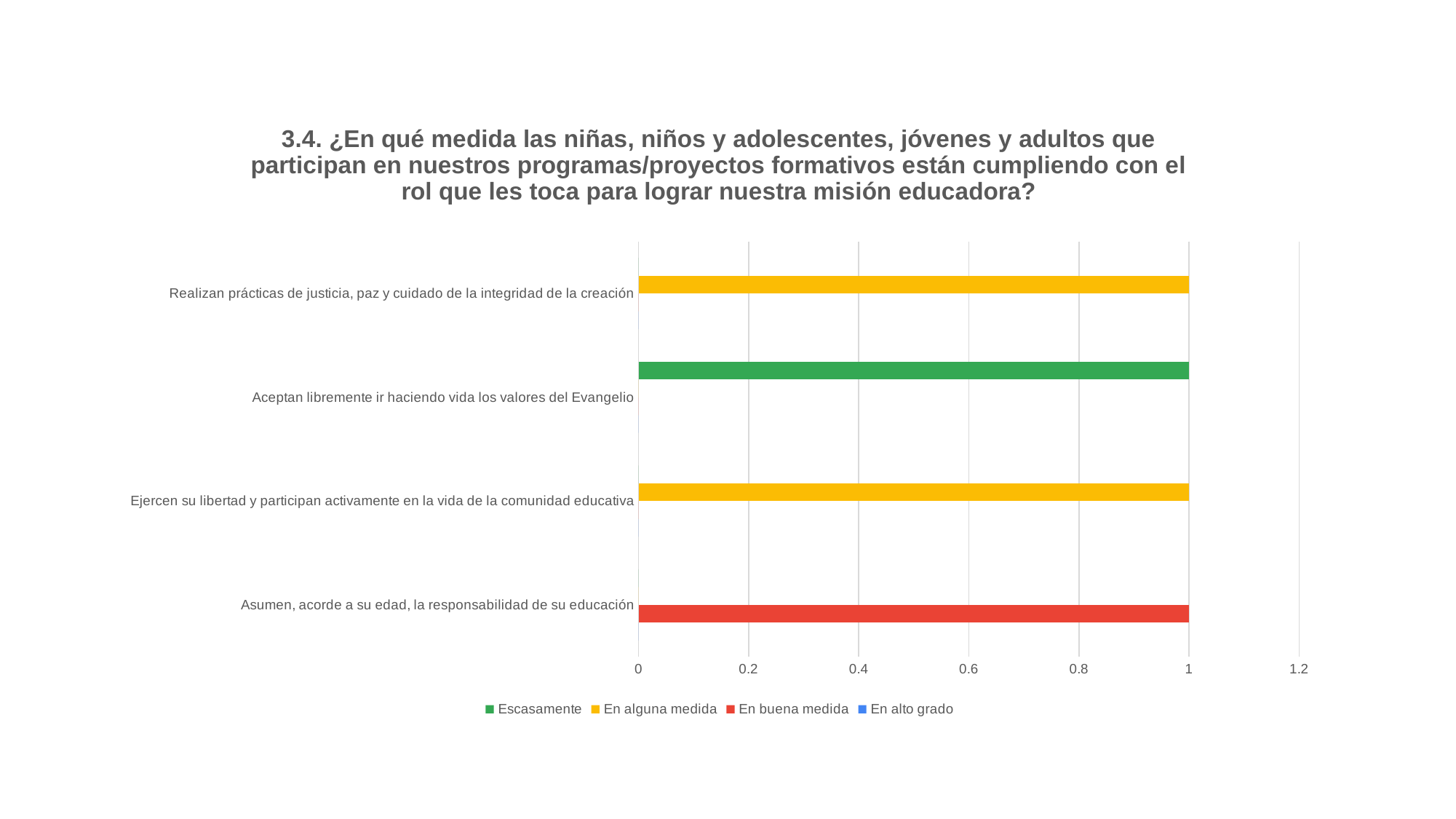
What kind of chart is shown on the slide? bar chart Is the value for "Ejercen su libertad y participan activamente en la vida de la comunidad educativa" greater or less than 1.2? less What is the value of the bar for "Ejercen su libertad y participan activamente en la vida de la comunidad educativa"? 1 Is the value for "Realizan prácticas de justicia, paz y cuidado de la integridad de la creación" greater or less than 0.8? greater How many series does the legend list? 4 What is the value of the bar for "Aceptan libremente ir haciendo vida los valores del Evangelio"? 1 What is the difference between the values for "Realizan prácticas de justicia, paz y cuidado de la integridad de la creación" and "Asumen, acorde a su edad, la responsabilidad de su educación"? 0 Which series does the bar for "Aceptan libremente ir haciendo vida los valores del Evangelio" belong to? Escasamente What is the value of the bar for "Asumen, acorde a su edad, la responsabilidad de su educación"? 1 Which series does the bar for "Asumen, acorde a su edad, la responsabilidad de su educación" belong to? En buena medida How many categories are plotted on the chart? 4